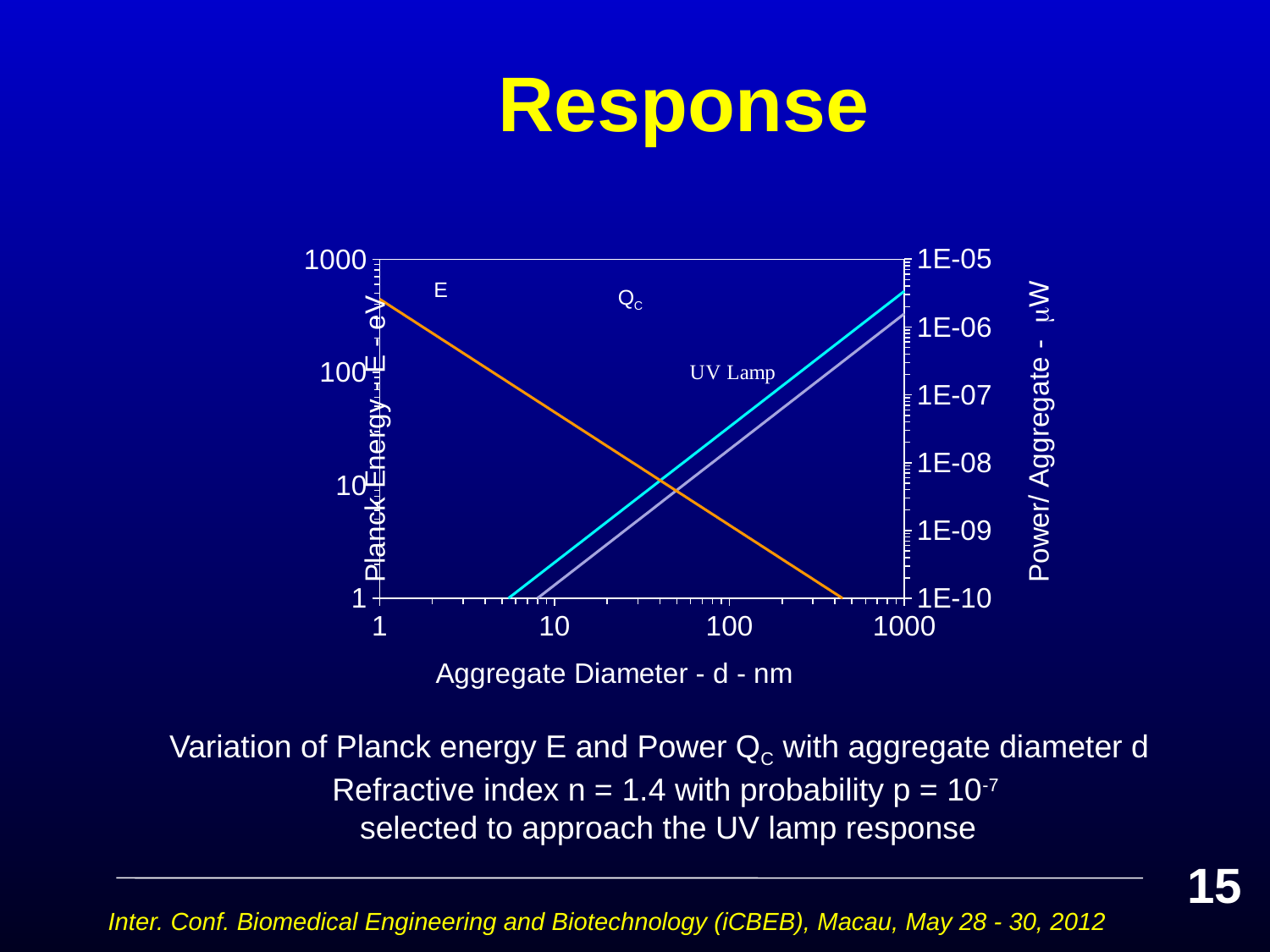
Is the Qc power at an aggregate diameter of 1000 nm greater or less than 1E-06 µW? greater What is the label of the x axis of the chart? Aggregate Diameter - d - nm Does the Planck energy E line rise or fall as aggregate diameter d increases? fall Which line has the highest value at an aggregate diameter of 1 nm? E What kind of chart is shown on the slide? line chart At an aggregate diameter of 1000 nm, which line is higher on the power axis, Qc or UV Lamp? Qc Is the Planck energy E at an aggregate diameter of 1 nm greater or less than 100 eV? greater Does the UV Lamp line rise or fall as aggregate diameter d increases? rise Does the Qc line rise or fall as aggregate diameter d increases? rise What is the label of the right-hand y axis of the chart? Power/ Aggregate - µW Is the Planck energy E at an aggregate diameter of 10 nm greater or less than 10 eV? greater How many lines are plotted on the chart? 3